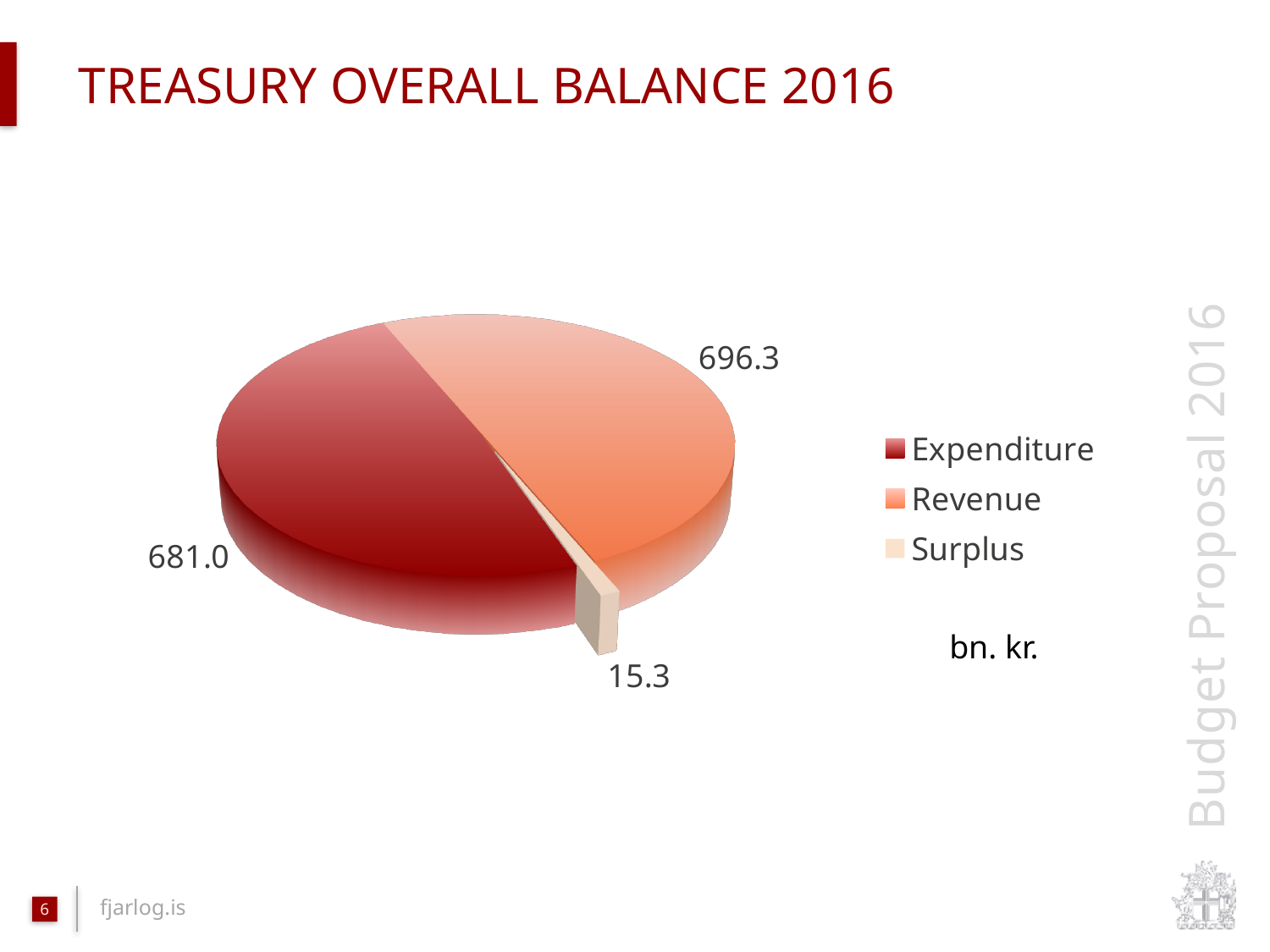
Which is larger, Expenditure or Surplus? Expenditure What is the value for Expenditure? 681.0 What is the difference between Revenue and Expenditure? 15.3 What unit is stated for the values in the chart? bn. kr. What share of the pie does Revenue represent? 50% Which slice of the pie is the largest? Revenue How many slices does the pie chart have? 3 Which slice of the pie is the smallest? Surplus What kind of chart is shown on the slide? Pie chart What is the value for Surplus? 15.3 What is the value for Revenue? 696.3 What is the difference between Expenditure and Surplus? 665.7